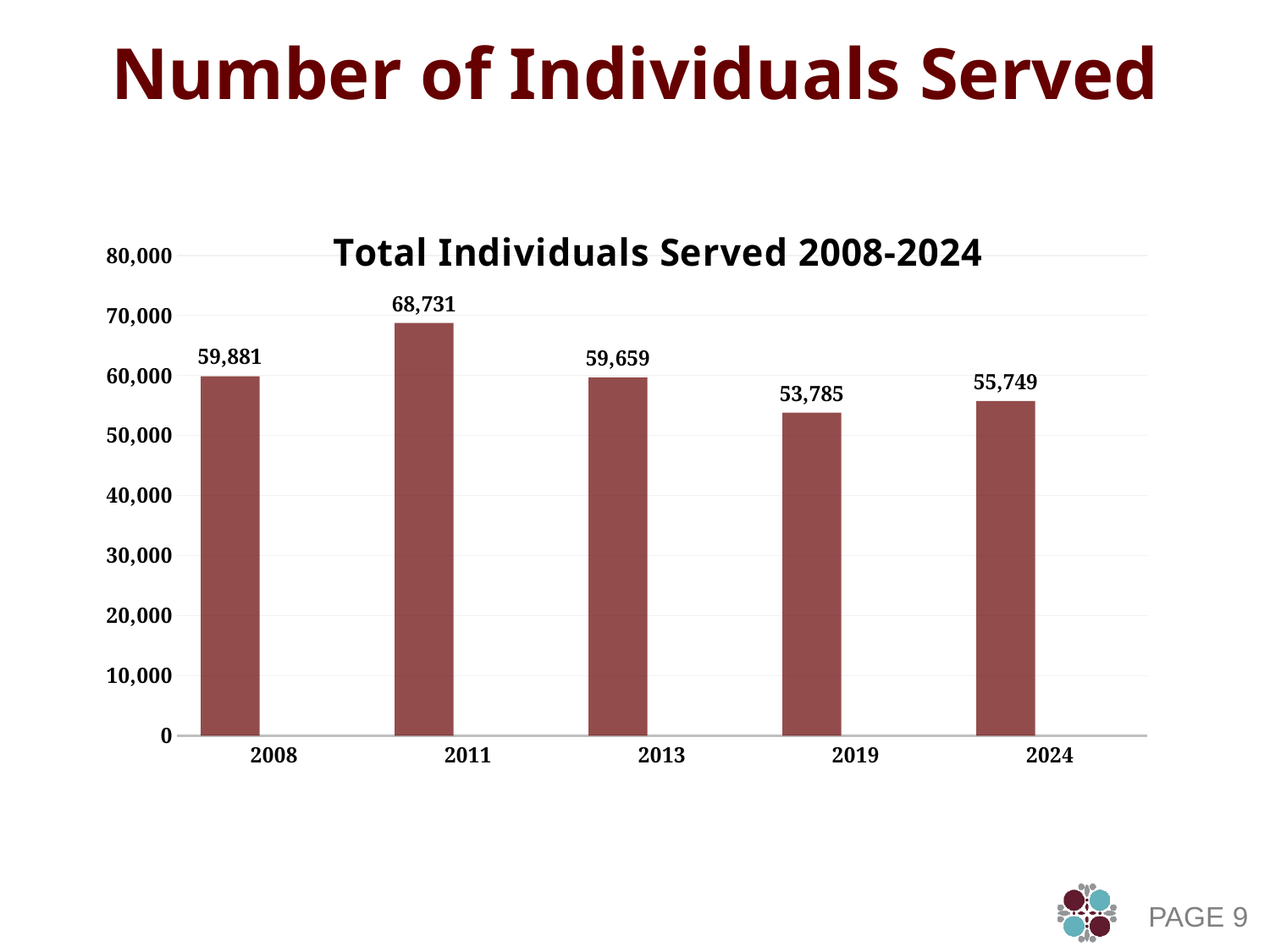
Which is larger, the value for 2008 or the value for 2024? 2008 What is the difference between the values for 2011 and 2019? 14,946 What is the difference between the values for 2024 and 2019? 1,964 What is the value for 2011? 68,731 How many years are shown on the x axis? 5 What is the value for 2019? 53,785 Is the value for 2013 greater or less than 50,000? greater What is the value for 2024? 55,749 Which year has the lowest number of individuals served? 2019 What kind of chart is shown on the slide? bar chart What is the title of the chart? Total Individuals Served 2008-2024 Which year has the highest number of individuals served? 2011